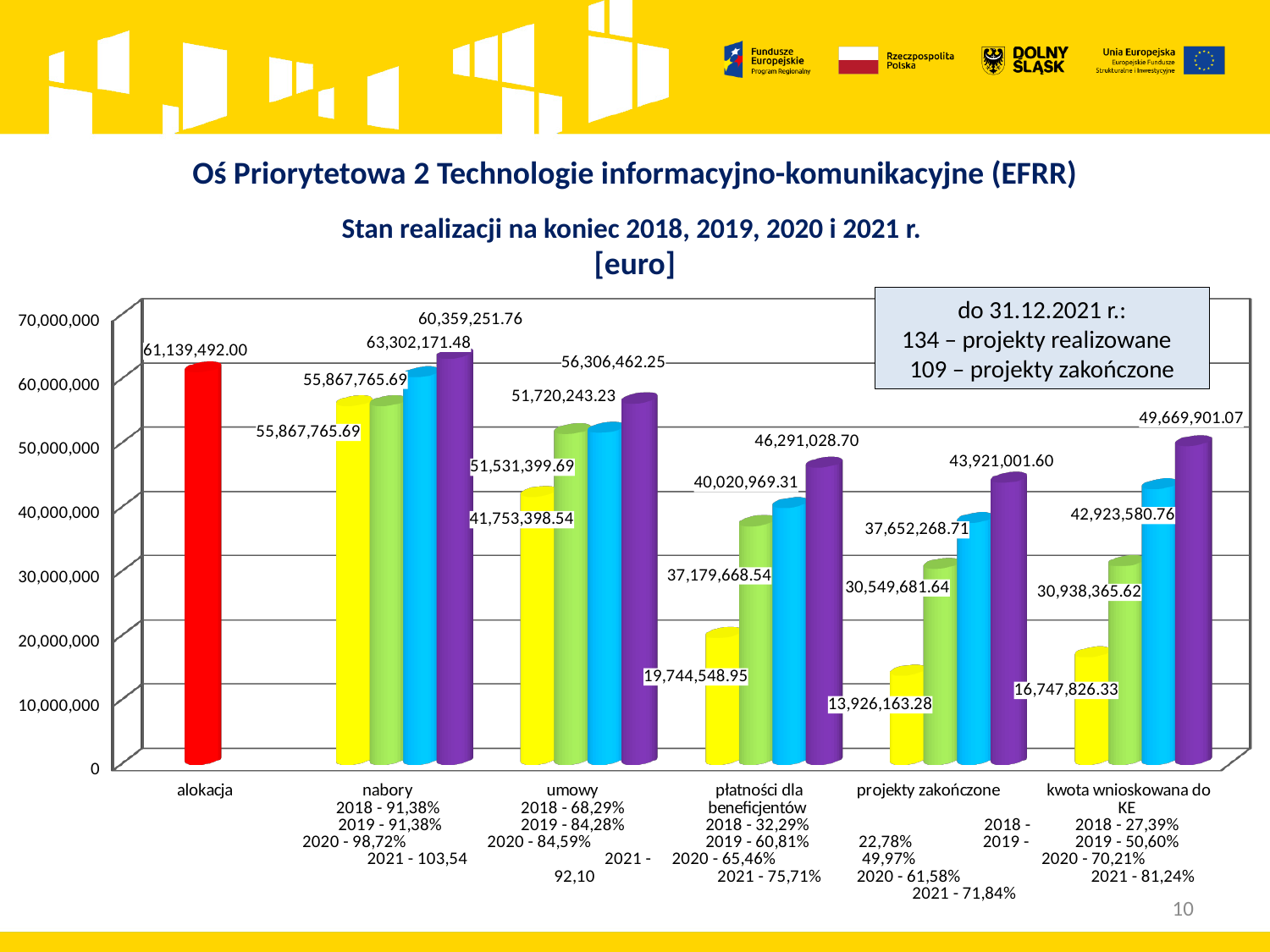
What is the highest value shown in the płatności dla beneficjentów group? 46,291,028.70 Which is larger: the highest value in the umowy group or the highest value in the płatności dla beneficjentów group? umowy What is the difference between the highest nabory value (63,302,171.48) and the alokacja value (61,139,492.00)? 2,162,679.48 Is the value of the alokacja bar greater or less than 60,000,000? greater Within the projekty zakończone group, do the bars rise or fall from left to right? rise How many categories are shown along the x axis of the chart? 6 What is the lowest value shown in the projekty zakończone group? 13,926,163.28 According to the text box on the chart, how many projects were completed (projekty zakończone) as of 31.12.2021? 109 What is the value of the alokacja bar? 61,139,492.00 What is the lowest value shown in the umowy group? 41,753,398.54 What kind of chart is shown on the slide? bar chart What is the highest value shown in the kwota wnioskowana do KE group? 49,669,901.07